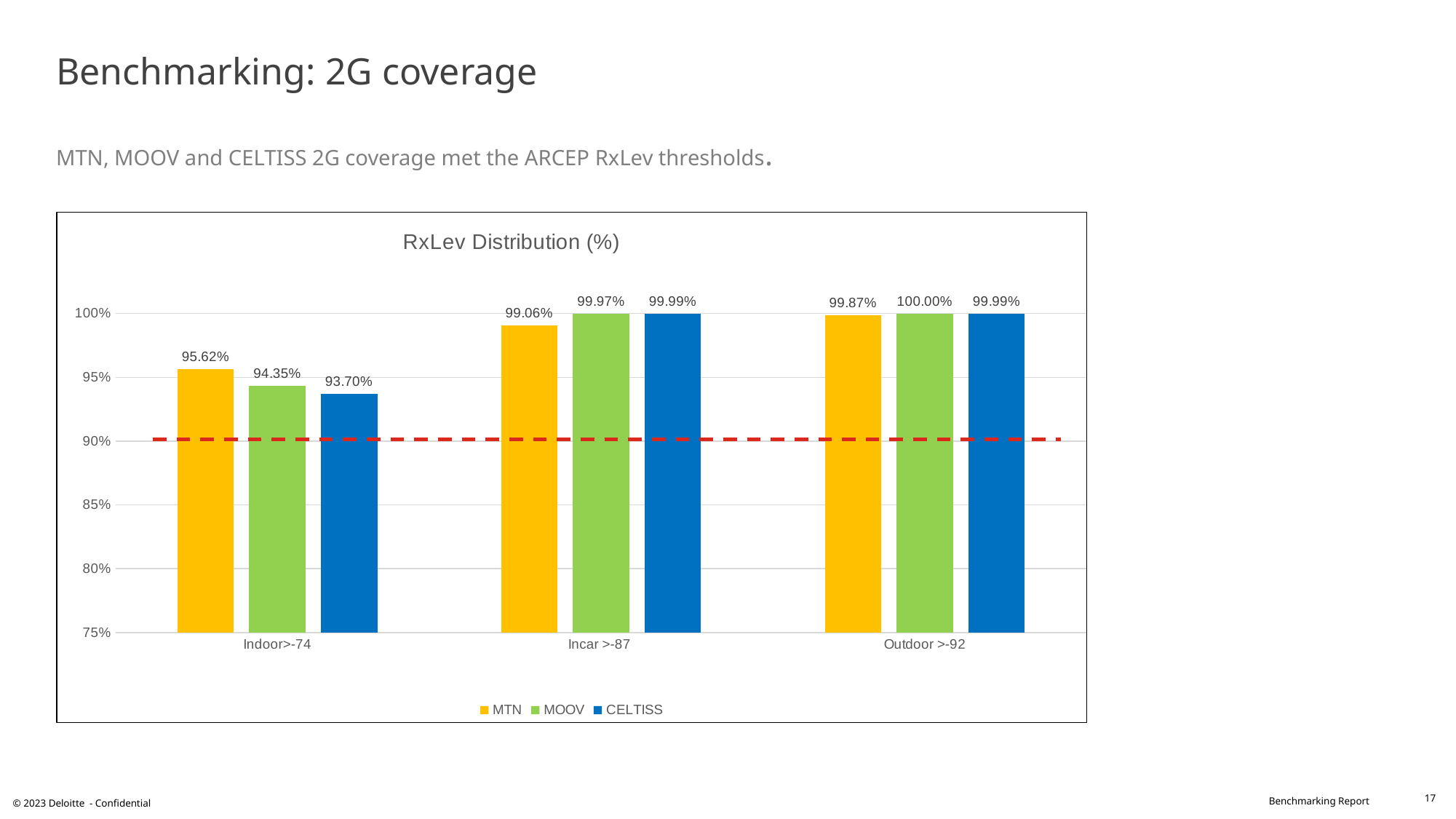
What is the difference between the MTN and MOOV values for Indoor>-74? 1.27% How many series does the legend list? 3 Is the CELTISS value for Indoor>-74 greater or less than 90%? greater Which operator has the lowest value for Indoor>-74? CELTISS What is the MTN value for Indoor>-74? 95.62% Which operator has the highest value for Indoor>-74? MTN What is the MOOV value for Outdoor >-92? 100.00% What is the CELTISS value for Incar >-87? 99.99% How many categories are shown on the x axis? 3 What kind of chart is shown on the slide? bar chart What is the title of the chart? RxLev Distribution (%) Which is larger for Incar >-87: the MTN value or the MOOV value? MOOV